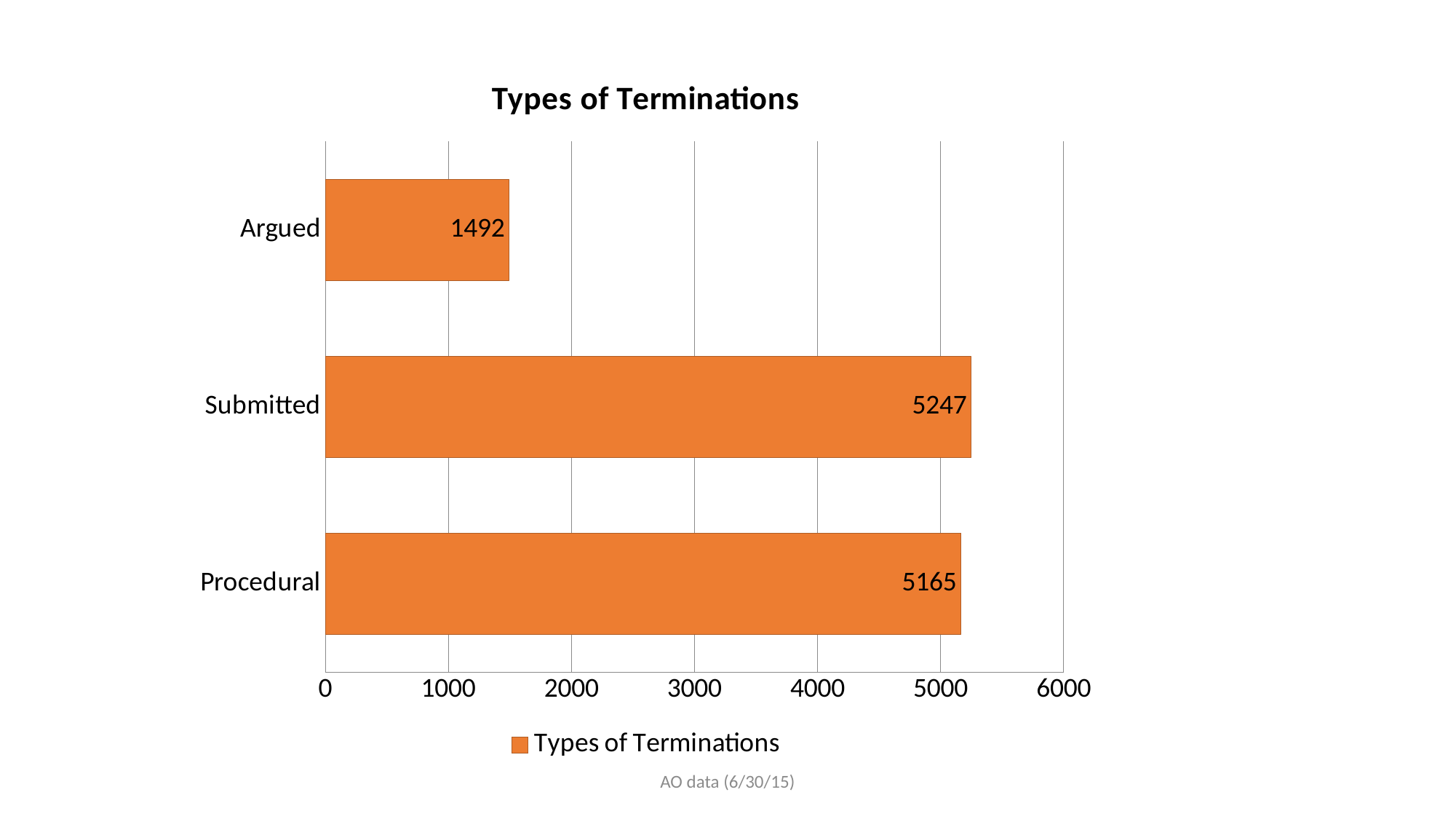
What is the value for Submitted? 5247 What is the difference between the values for Submitted and Argued? 3755 Which is larger, the value for Procedural or the value for Argued? Procedural What is the title of the chart? Types of Terminations Is the value for Argued greater or less than 2000? less What is the value for Argued? 1492 What kind of chart is shown on the slide? bar chart How many categories are shown in the chart? 3 What is the value for Procedural? 5165 Which category has the lowest value? Argued What is the difference between the values for Submitted and Procedural? 82 Which category has the highest value? Submitted